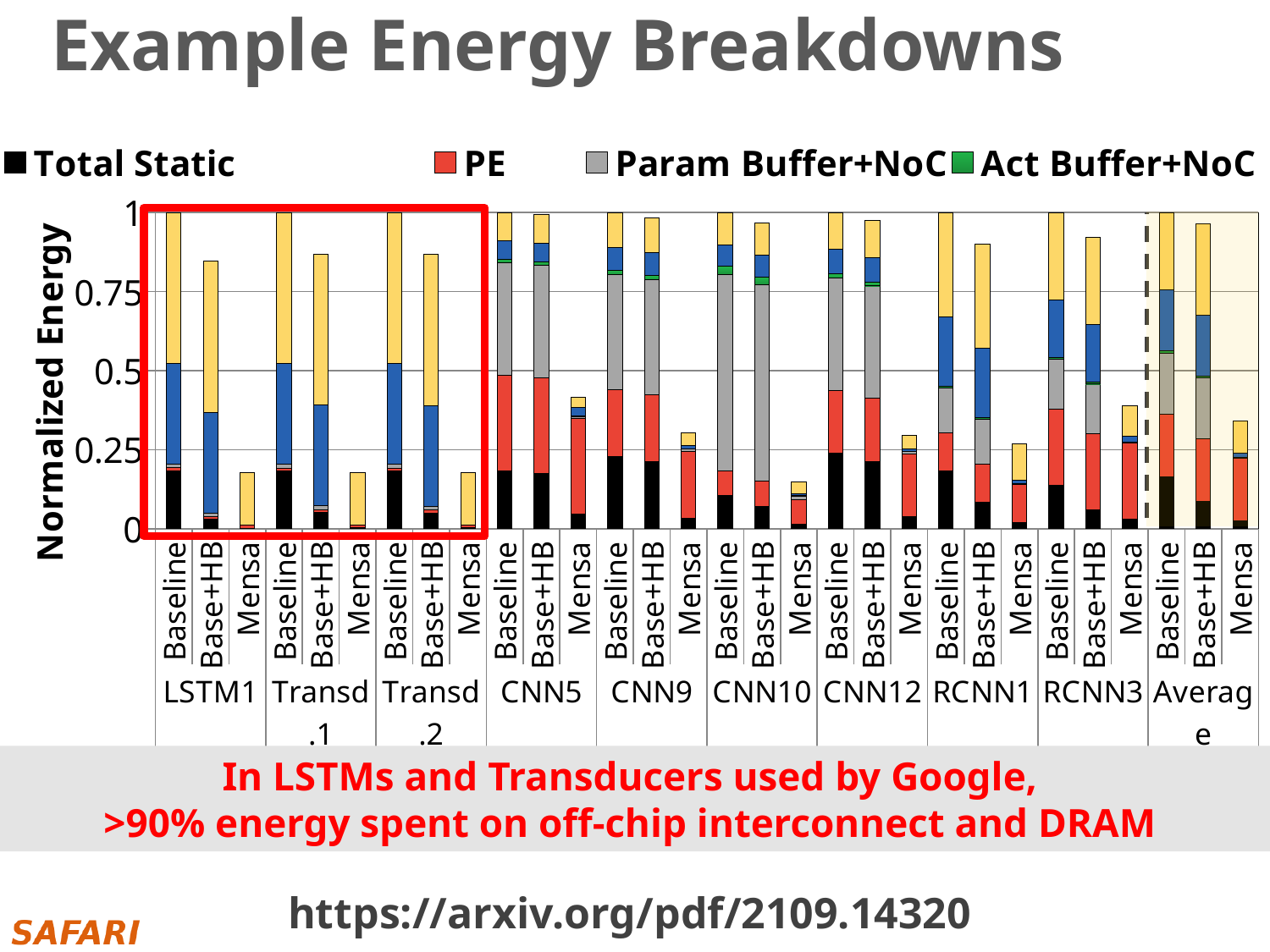
What is the total normalized energy of the Baseline bar for LSTM1? 1 Which has the larger total normalized energy: Mensa in CNN5 or Mensa in LSTM1? Mensa in CNN5 Is the total normalized energy for Mensa in LSTM1 greater or less than 0.25? less Is the total normalized energy for Mensa in the Average group greater or less than 0.25? greater Is the total normalized energy for Mensa in CNN5 greater or less than 0.5? less What kind of chart is shown on the slide? Stacked bar chart What is the label of the y axis? Normalized Energy Within the CNN5 group, which configuration has the lowest total normalized energy? Mensa How many workload groups (including Average) are shown along the x axis? 10 How many bars are shown for each workload group? 3 How many series does the chart legend list? 4